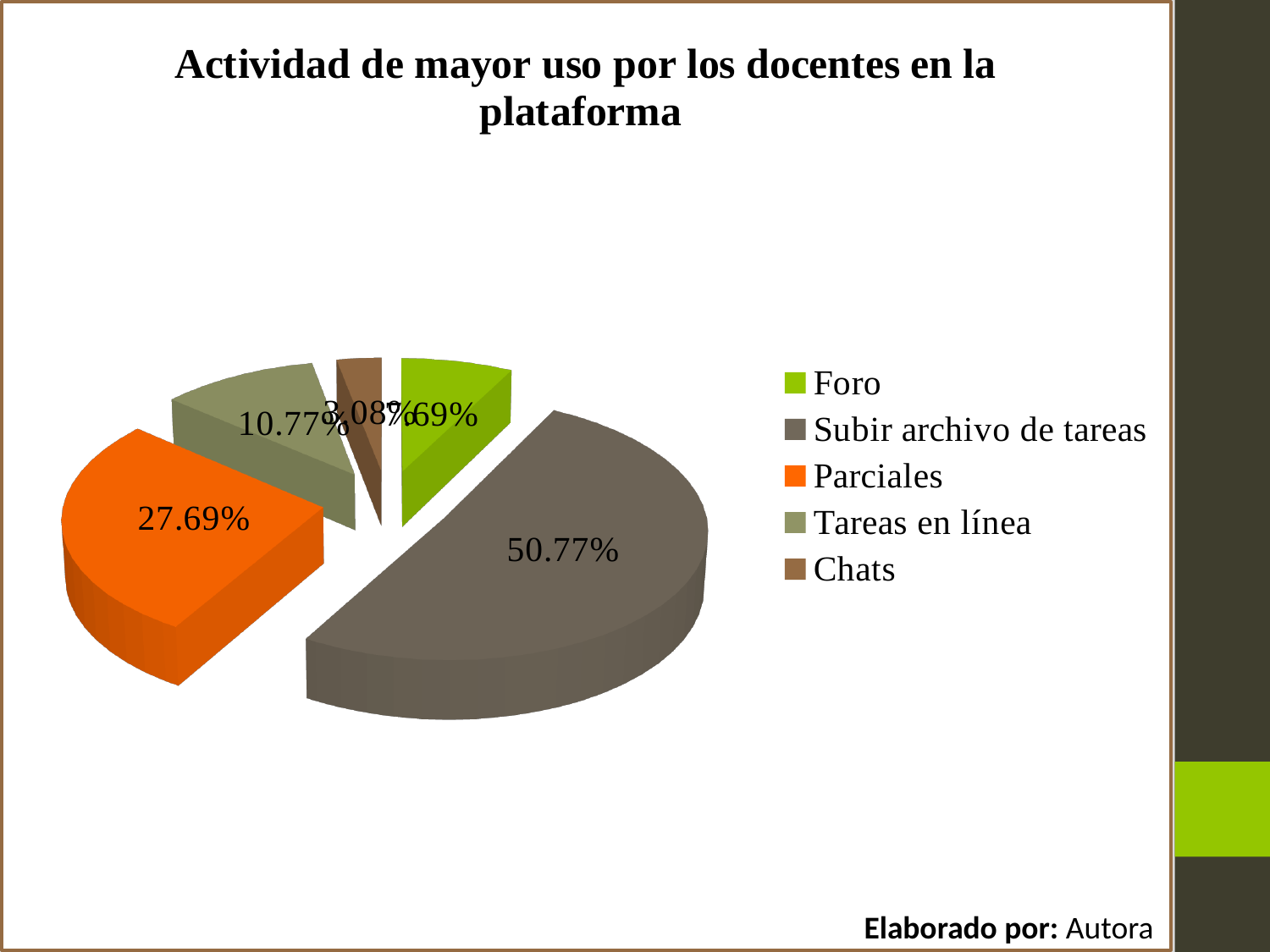
What is the difference in percentage points between 'Subir archivo de tareas' and 'Parciales'? 23.08% Which slice is larger, 'Parciales' or 'Tareas en línea'? Parciales What percentage of the pie does 'Tareas en línea' represent? 10.77% What percentage of the pie does 'Subir archivo de tareas' represent? 50.77% What percentage of the pie does 'Parciales' represent? 27.69% What is the title of the chart? Actividad de mayor uso por los docentes en la plataforma Which category has the smallest slice of the pie? Chats How many categories does the legend of the pie chart list? 5 What is the difference in percentage points between 'Parciales' and 'Tareas en línea'? 16.92% What kind of chart is shown on the slide? pie chart Which slice is larger, 'Foro' or 'Chats'? Foro Which category has the largest slice of the pie? Subir archivo de tareas